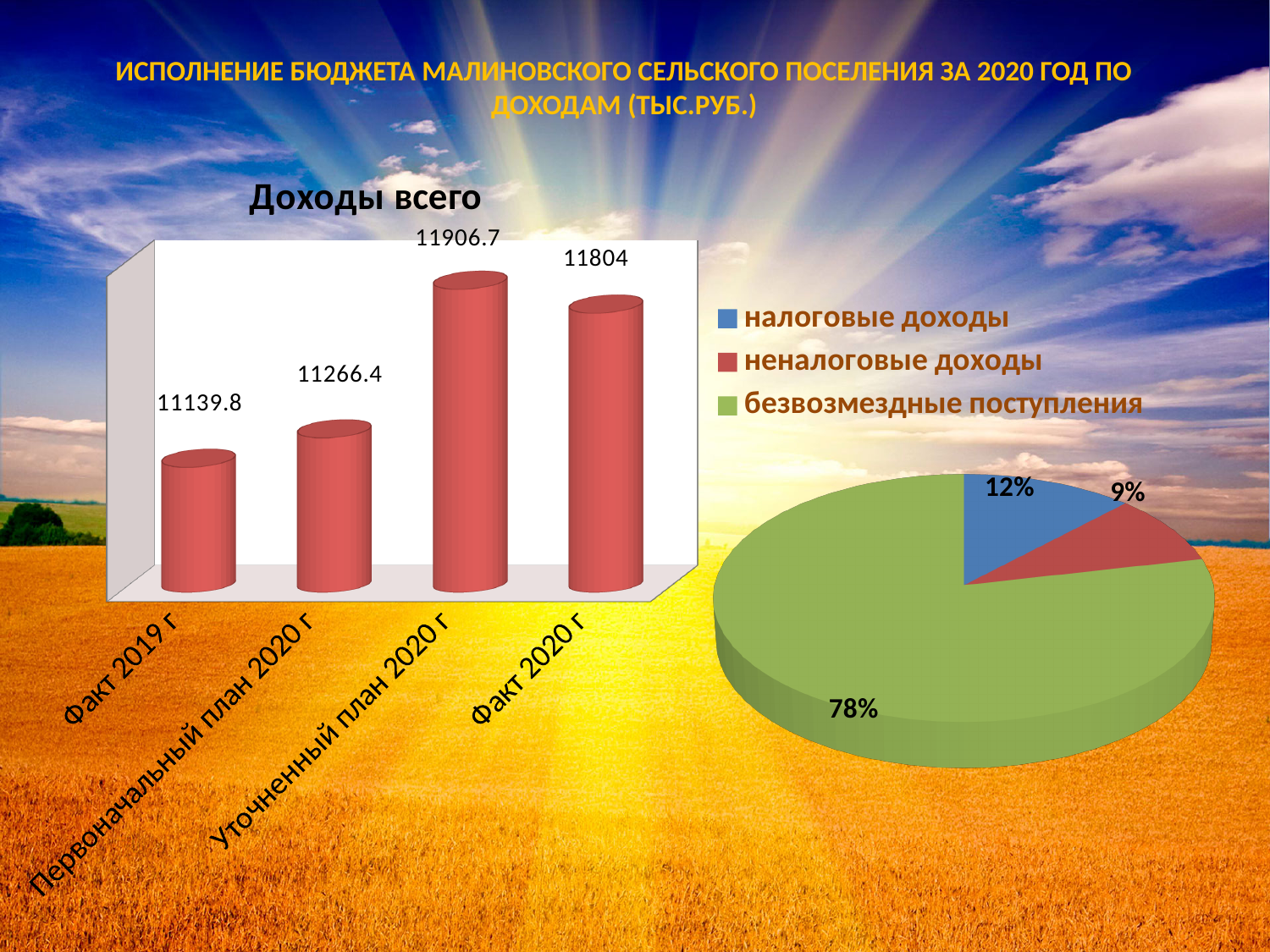
In the 'Доходы всего' bar chart, which is larger: Первоначальный план 2020 г or Факт 2019 г? Первоначальный план 2020 г How many categories are shown in the 'Доходы всего' bar chart? 4 In the 'Доходы всего' bar chart, what is the value for Факт 2020 г? 11804 In the 'Доходы всего' bar chart, what is the value for Факт 2019 г? 11139.8 In the pie chart on the right, what share is неналоговые доходы? 9% In the 'Доходы всего' bar chart, what is the difference between Уточненный план 2020 г and Факт 2020 г? 102.7 How many entries does the legend of the pie chart on the right list? 3 In the 'Доходы всего' bar chart, which category has the lowest value? Факт 2019 г In the pie chart on the right, what share is безвозмездные поступления? 78% In the 'Доходы всего' bar chart, what is the value for Уточненный план 2020 г? 11906.7 What type of chart is the 'Доходы всего' chart on the left? Bar chart In the 'Доходы всего' bar chart, which category has the highest value? Уточненный план 2020 г